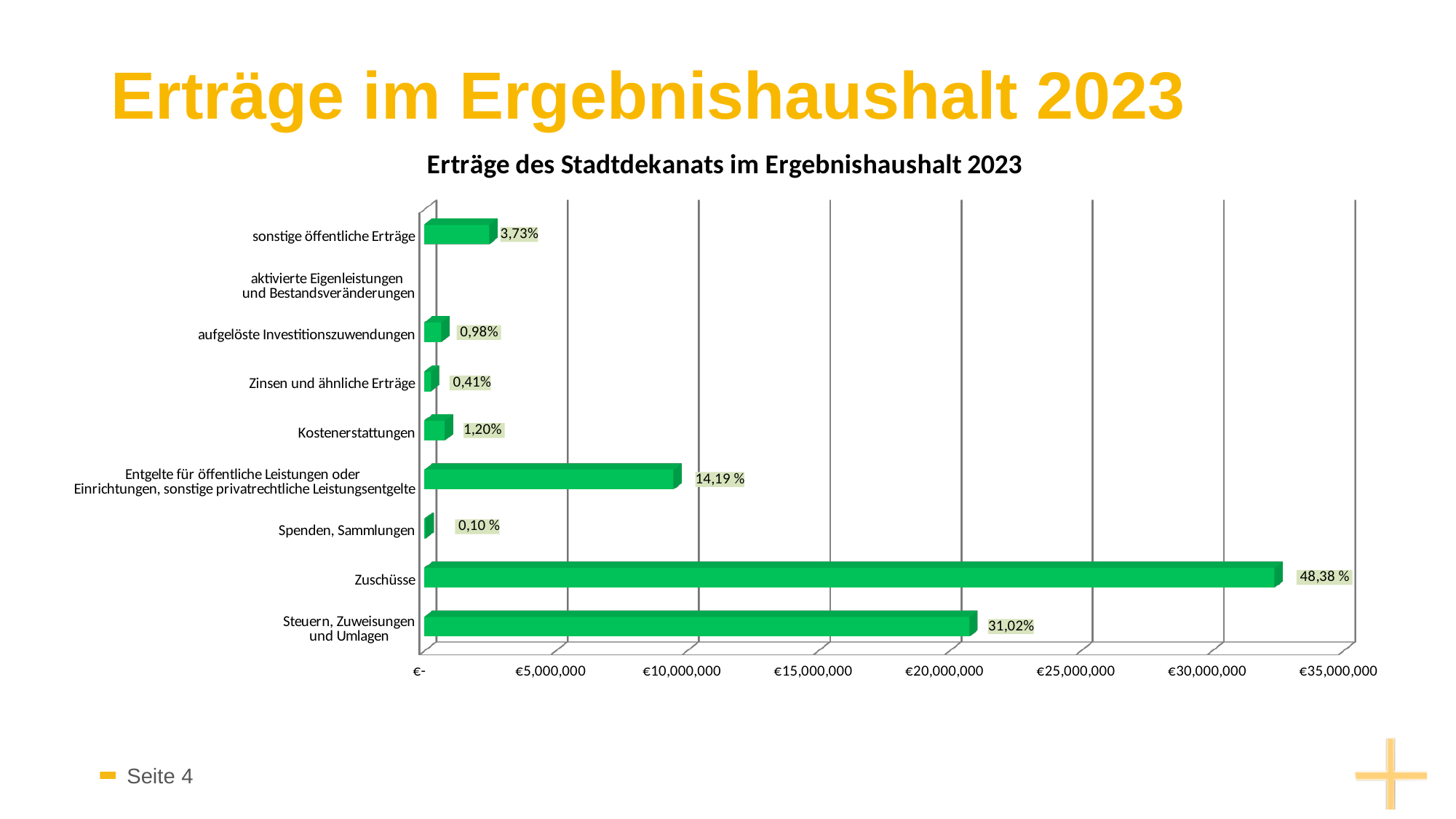
Which category has the smallest percentage label? Spenden, Sammlungen What percentage label is shown for Steuern, Zuweisungen und Umlagen? 31,02% What percentage label is shown for sonstige öffentliche Erträge? 3,73% What percentage label is shown for Zinsen und ähnliche Erträge? 0,41% Which is larger, the bar for Kostenerstattungen or the bar for aufgelöste Investitionszuwendungen? Kostenerstattungen What kind of chart is shown on the slide? bar chart Is the value for Zuschüsse greater or less than €30,000,000? greater What percentage label is shown for Zuschüsse? 48,38 % What percentage label is shown for Entgelte für öffentliche Leistungen oder Einrichtungen, sonstige privatrechtliche Leistungsentgelte? 14,19 % Is the value for Entgelte für öffentliche Leistungen oder Einrichtungen, sonstige privatrechtliche Leistungsentgelte greater or less than €10,000,000? less By how many percentage points does the label for Zuschüsse exceed the label for Steuern, Zuweisungen und Umlagen? 17,36 % Which category has the largest bar? Zuschüsse